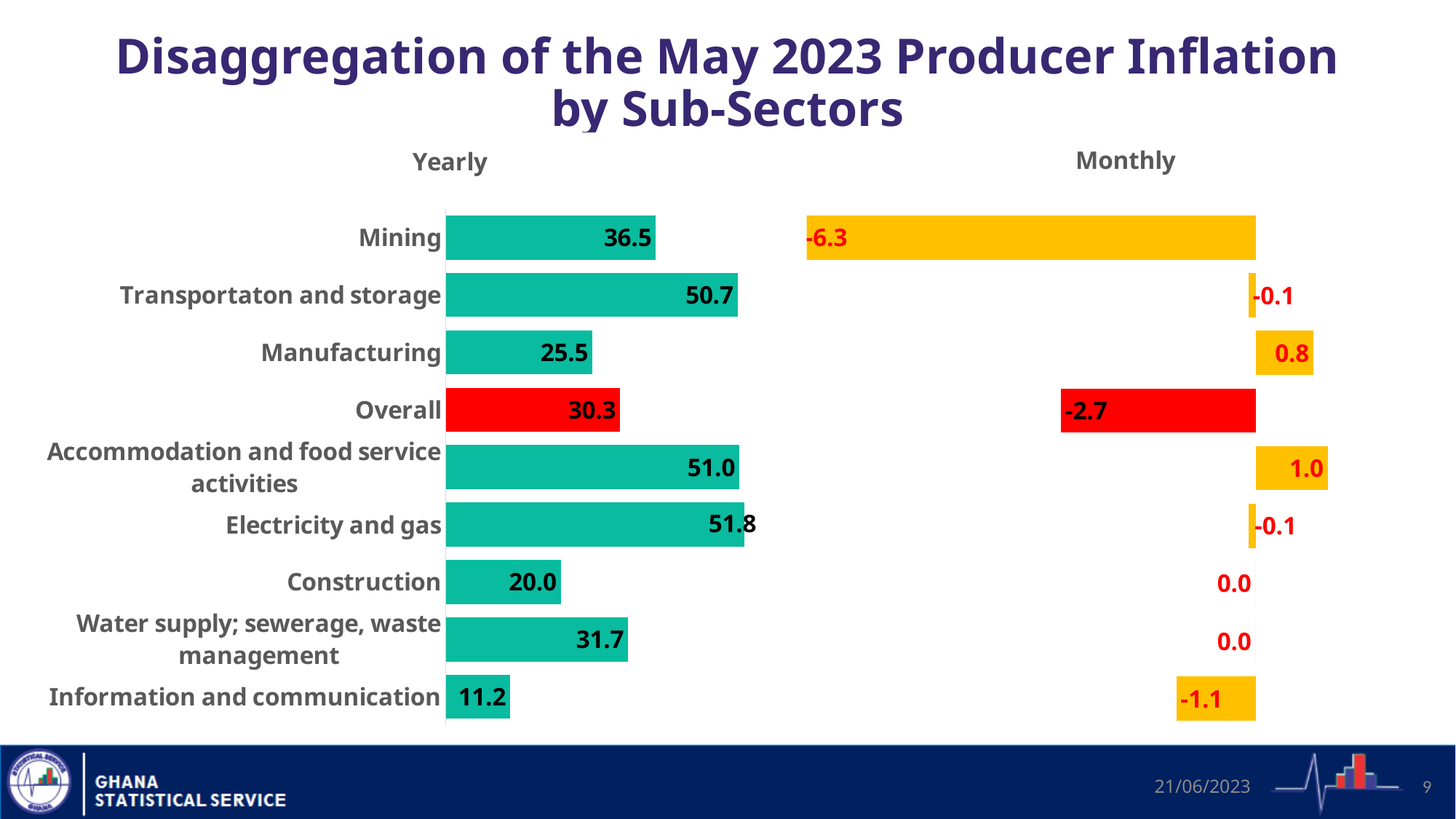
In the Monthly chart, which category has the highest value? Accommodation and food service activities In the Monthly chart, what is the value for Information and communication? -1.1 In the Yearly chart, what is the value for Mining? 36.5 In the Yearly chart, what is the difference between Transportaton and storage and Manufacturing? 25.2 In the Yearly chart, which category has the lowest value? Information and communication In the Yearly chart, which category's bar is coloured red rather than green? Overall In the Monthly chart, what is the value for Overall? -2.7 How many categories are shown in the Yearly chart? 9 In the Yearly chart, which is larger: Overall or Water supply; sewerage, waste management? Water supply; sewerage, waste management What kind of chart is the Monthly chart? Bar chart In the Yearly chart, which category has the highest value? Electricity and gas In the Monthly chart, which category has the lowest value? Mining